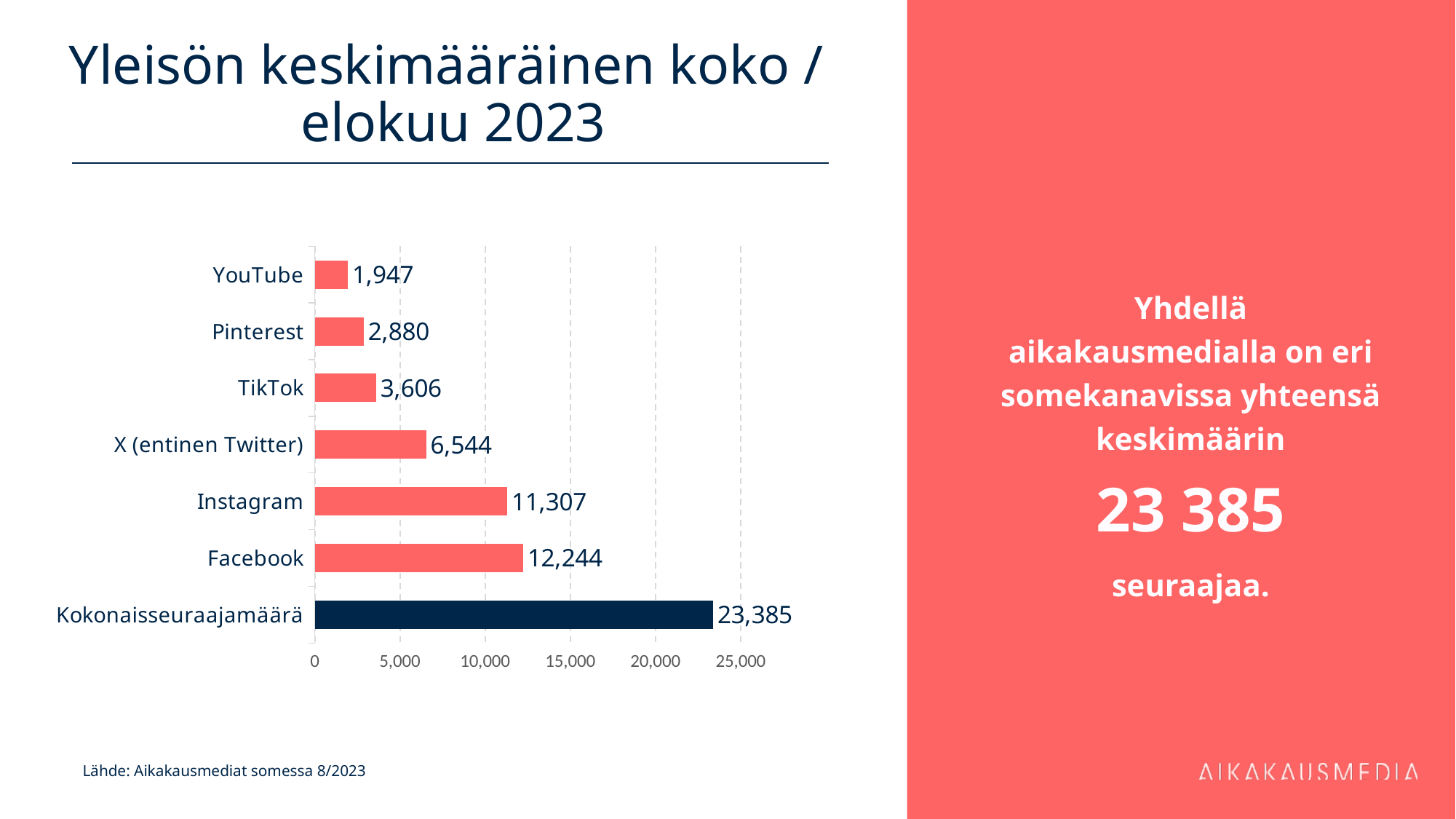
What is the value for Facebook? 12,244 What is the value for Kokonaisseuraajamäärä? 23,385 Which is larger, the value for Pinterest or the value for YouTube? Pinterest What is the title of the slide? Yleisön keskimääräinen koko / elokuu 2023 Which category has the lowest value? YouTube What kind of chart is shown on the slide? Bar chart Is the value for Instagram greater or less than 10,000? greater Which individual social media channel (excluding Kokonaisseuraajamäärä) has the highest value? Facebook How many categories are shown in the chart? 7 What is the value for TikTok? 3,606 What is the difference between the values for X (entinen Twitter) and TikTok? 2,938 What is the difference between the values for Facebook and Instagram? 937